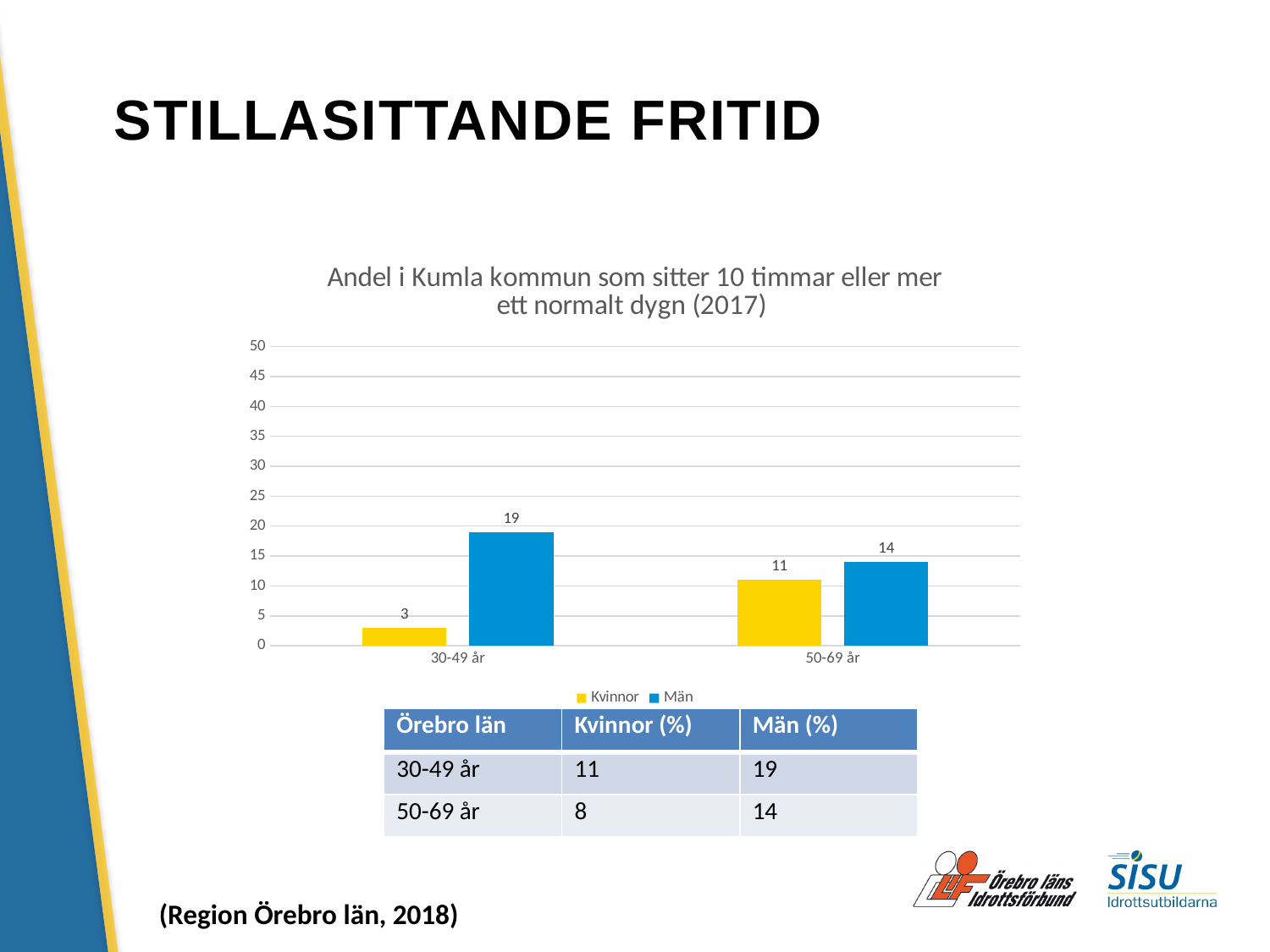
Which bar in the chart has the lowest value? Kvinnor, 30-49 år What is the difference between the Män and Kvinnor values in the 30-49 år category? 16 Is the value for Män in the 50-69 år category greater or less than 10? greater What is the value for Män in the 30-49 år category? 19 How many series does the chart legend list? 2 Which is larger in the 50-69 år category, Kvinnor or Män? Män How many age categories are shown on the x axis of the chart? 2 What is the value for Män in the 50-69 år category? 14 What is the value for Kvinnor in the 30-49 år category? 3 What is the value for Kvinnor in the 50-69 år category? 11 What type of chart is shown on the slide? Bar chart Which bar in the chart has the highest value? Män, 30-49 år